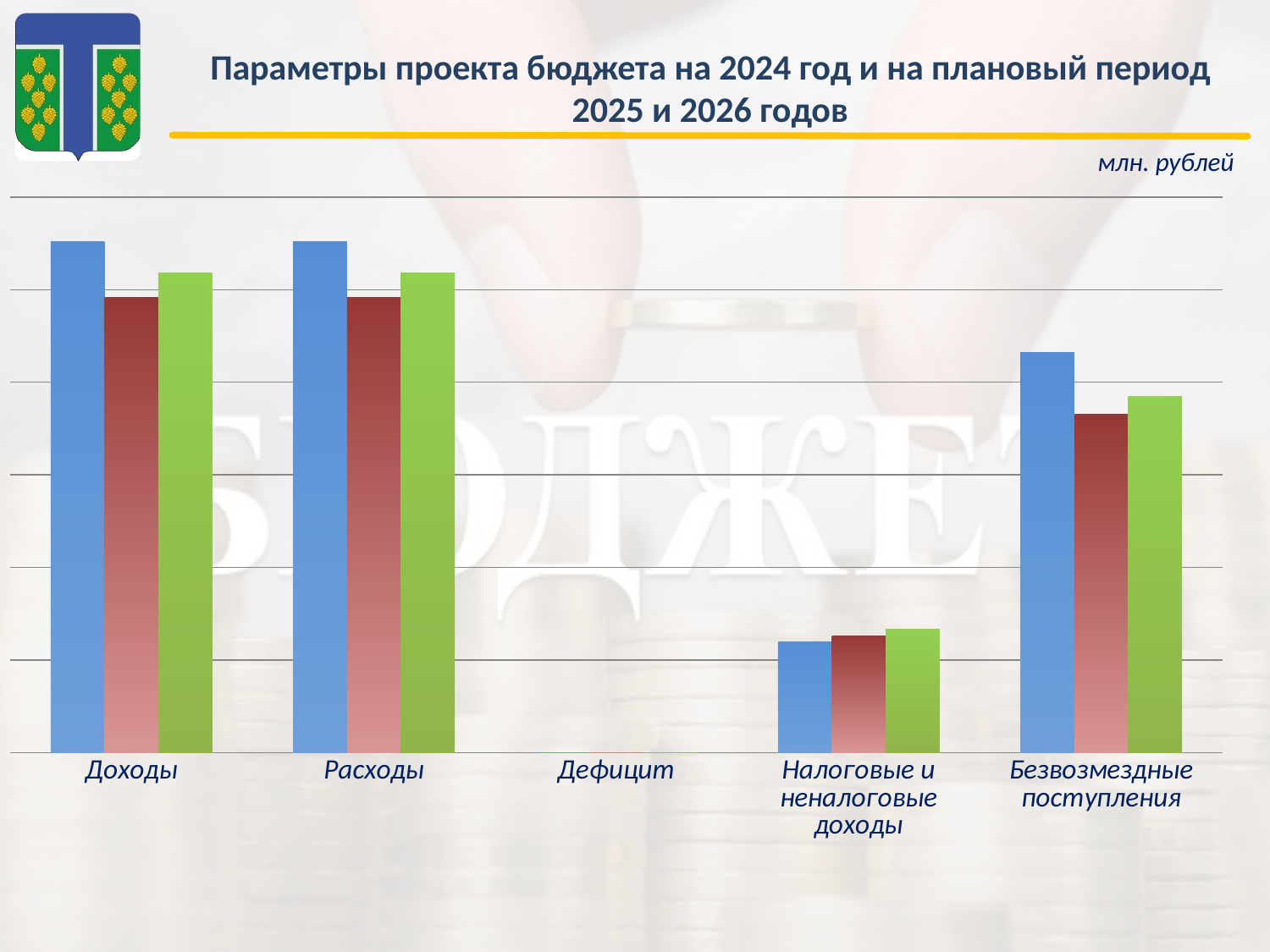
What kind of chart is shown on the slide? bar chart For the category Безвозмездные поступления, is the red bar or the green bar taller? green Is the green bar for Налоговые и неналоговые доходы taller or shorter than the green bar for Безвозмездные поступления? shorter For the category Налоговые и неналоговые доходы, do the bars rise or fall from left to right? rise What unit of measurement is stated on the slide for the chart values? млн. рублей For the category Доходы, is the blue bar or the red bar taller? blue What three colours are used for the bars in each category? blue, red, green Which category on the chart has no visible bars? Дефицит How many categories are labelled on the x axis of the chart? 5 How many bars are plotted for the category Доходы? 3 Among the categories with visible bars, which has the shortest bars? Налоговые и неналоговые доходы